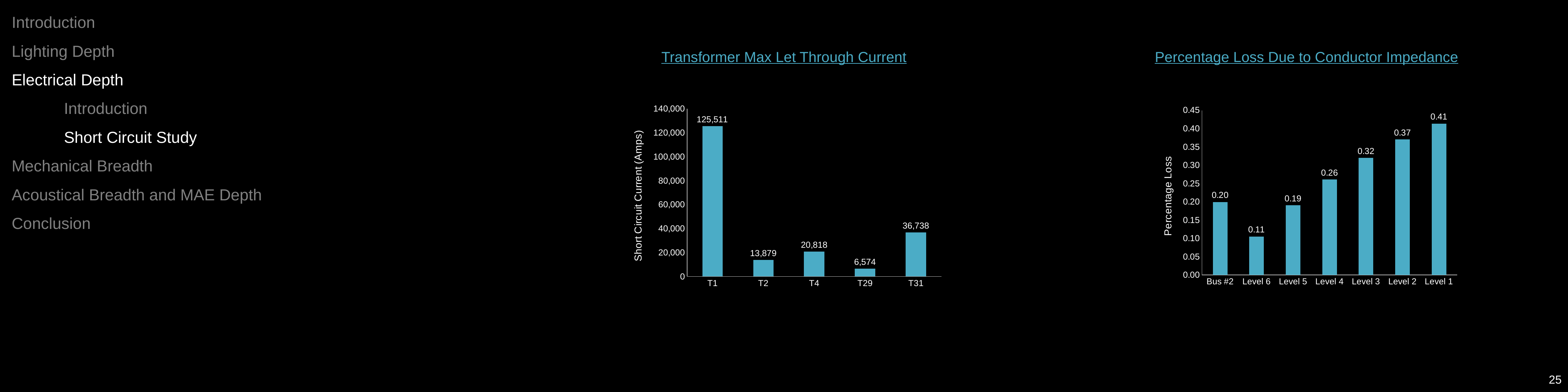
In the 'Percentage Loss Due to Conductor Impedance' chart, what is the percentage loss for Level 4? 0.26 In the 'Transformer Max Let Through Current' chart, which transformer has the lowest short circuit current? T29 What type of chart is the 'Percentage Loss Due to Conductor Impedance' chart? Bar chart In the 'Percentage Loss Due to Conductor Impedance' chart, what is the difference between the values for Level 1 and Level 2? 0.04 In the 'Transformer Max Let Through Current' chart, what is the difference between the values for T31 and T2? 22,859 In the 'Percentage Loss Due to Conductor Impedance' chart, which category has the lowest percentage loss? Level 6 In the 'Transformer Max Let Through Current' chart, what is the y-axis label? Short Circuit Current (Amps) In the 'Transformer Max Let Through Current' chart, what is the short circuit current for T1? 125,511 In the 'Transformer Max Let Through Current' chart, how many transformers are shown on the x axis? 5 In the 'Percentage Loss Due to Conductor Impedance' chart, which category has the highest percentage loss? Level 1 In the 'Percentage Loss Due to Conductor Impedance' chart, how many categories are shown on the x axis? 7 In the 'Transformer Max Let Through Current' chart, which is larger, the value for T4 or the value for T2? T4